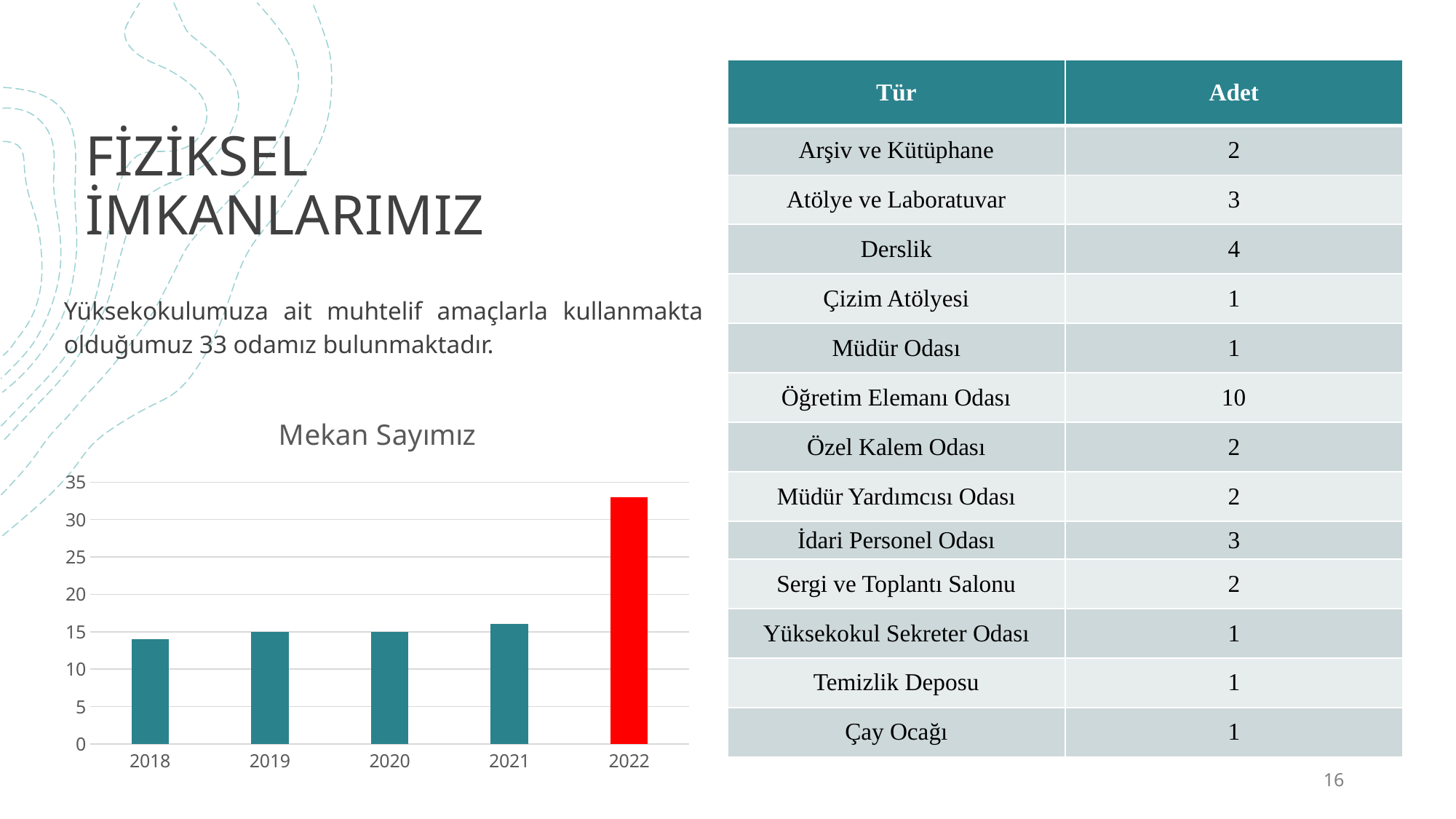
In the "Mekan Sayımız" chart, is the value for 2021 greater or less than 20? less Do the values in the "Mekan Sayımız" chart generally rise or fall from 2018 to 2022? rise What type of chart is shown under the title "Mekan Sayımız"? bar chart What is the highest value shown on the y axis of the "Mekan Sayımız" chart? 35 In the "Mekan Sayımız" chart, which is larger, the value for 2021 or the value for 2022? 2022 In the "Mekan Sayımız" chart, is the value for 2018 greater or less than 20? less In the "Mekan Sayımız" chart, which year's bar is coloured red? 2022 What is the title of the bar chart on the slide? Mekan Sayımız Which year has the highest value in the "Mekan Sayımız" chart? 2022 In the "Mekan Sayımız" chart, is the value for 2022 greater or less than 30? greater How many years are shown on the x axis of the "Mekan Sayımız" chart? 5